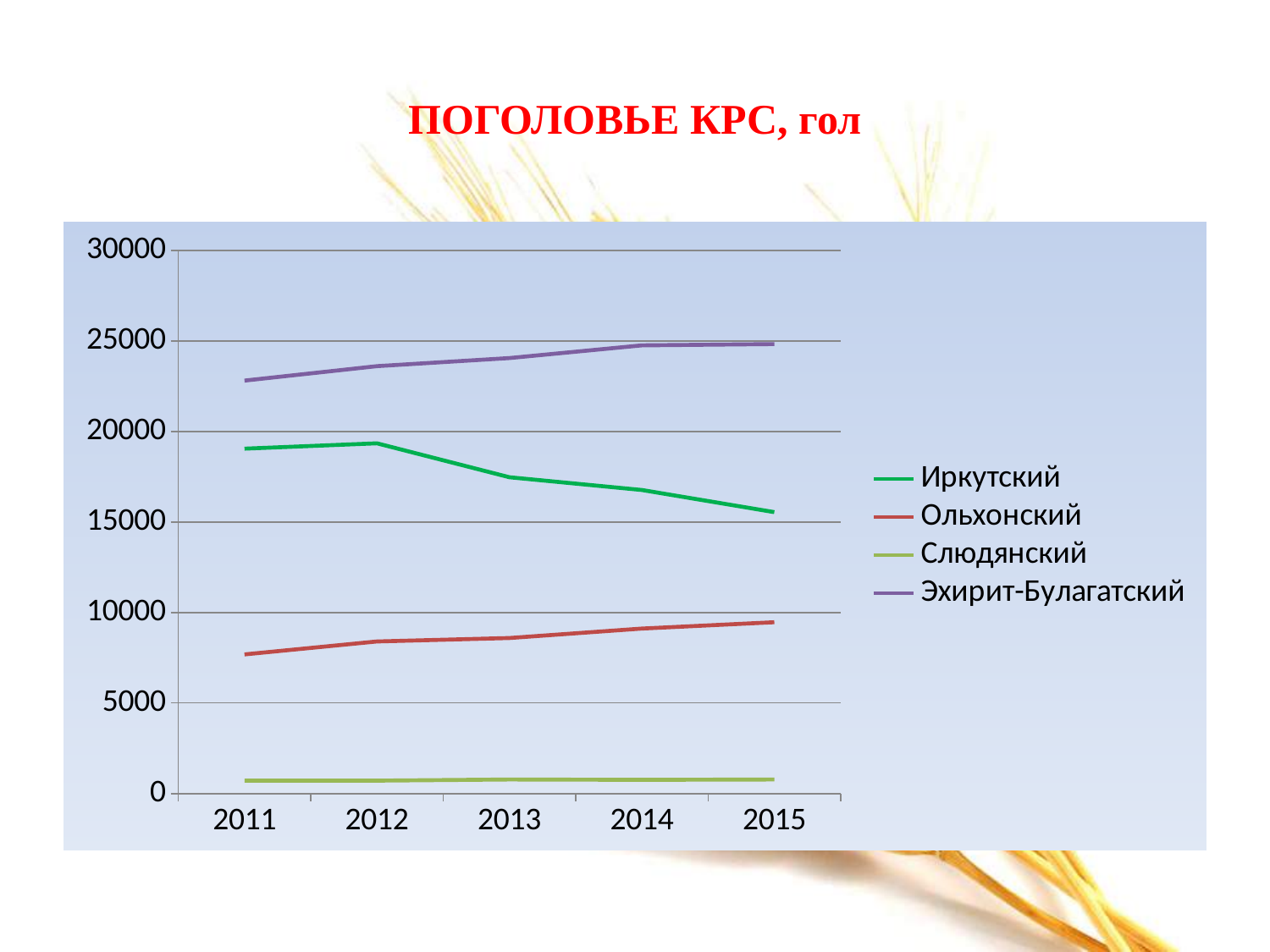
Is the value for Иркутский in 2011 greater or less than 20000? less Is the value for Ольхонский in 2015 greater or less than 10000? less Does the value for Эхирит-Булагатский rise or fall from 2011 to 2014? rise What kind of chart is shown on the slide? line chart Which series has the lowest values across all years? Слюдянский Does the value for Иркутский rise or fall from 2012 to 2015? fall What is the title of the slide? ПОГОЛОВЬЕ КРС, гол Does the value for Ольхонский rise or fall from 2011 to 2015? rise Which series has the highest values across all years? Эхирит-Булагатский Which is larger in 2015: the value for Иркутский or the value for Ольхонский? Иркутский How many series does the legend list? 4 How many years are shown on the x axis? 5